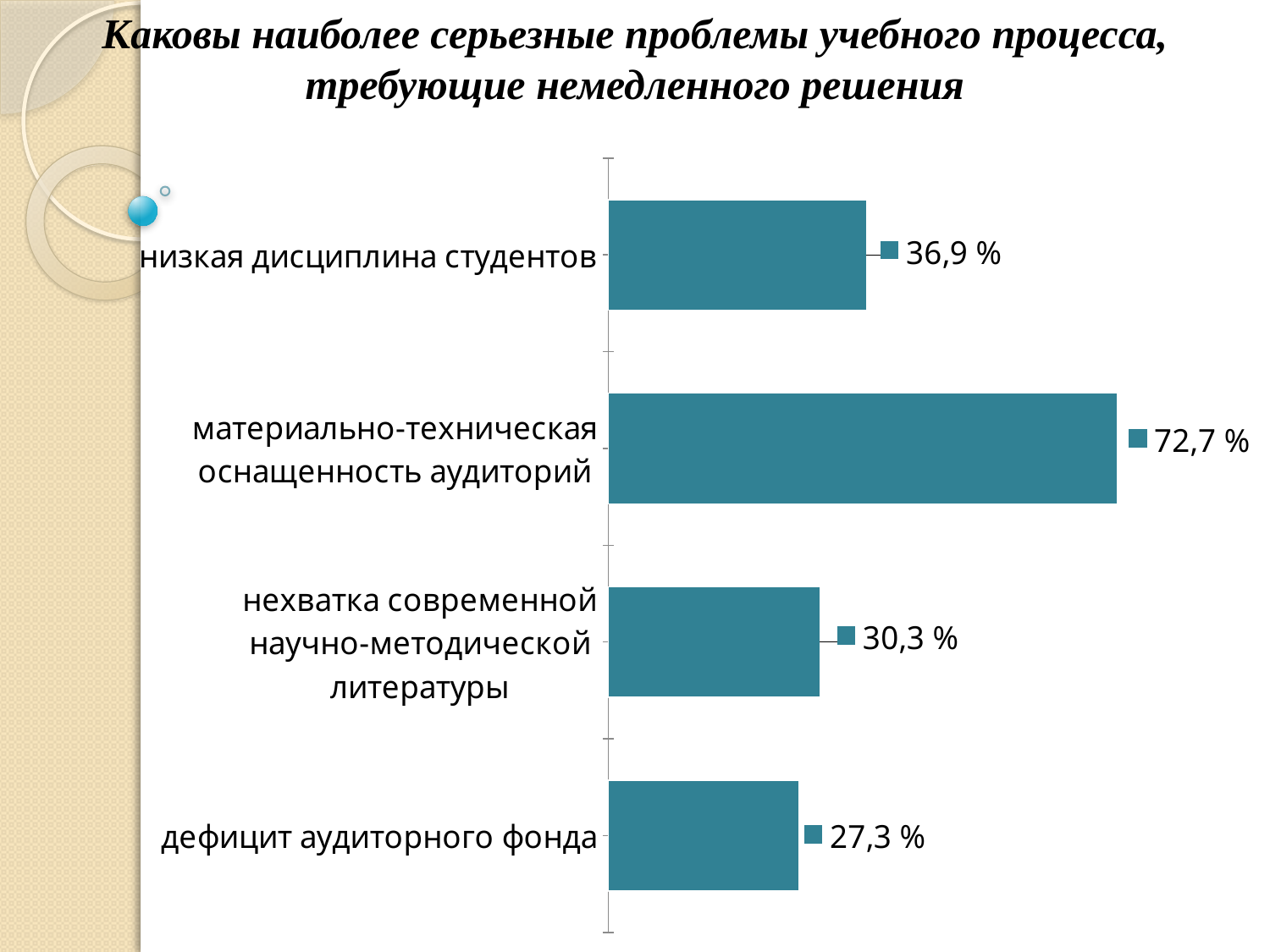
What is the difference between the values for "нехватка современной научно-методической литературы" and "дефицит аудиторного фонда"? 3,0 % How many categories are shown in the chart? 4 What is the title of the slide? Каковы наиболее серьезные проблемы учебного процесса, требующие немедленного решения What kind of chart is shown on the slide? bar chart What is the difference between the values for "материально-техническая оснащенность аудиторий" and "низкая дисциплина студентов"? 35,8 % What is the value for "низкая дисциплина студентов"? 36,9 % What is the value for "материально-техническая оснащенность аудиторий"? 72,7 % What is the value for "нехватка современной научно-методической литературы"? 30,3 % Which category has the lowest value? дефицит аудиторного фонда Which category has the highest value? материально-техническая оснащенность аудиторий What is the value for "дефицит аудиторного фонда"? 27,3 % Which is larger: the value for "низкая дисциплина студентов" or for "нехватка современной научно-методической литературы"? низкая дисциплина студентов